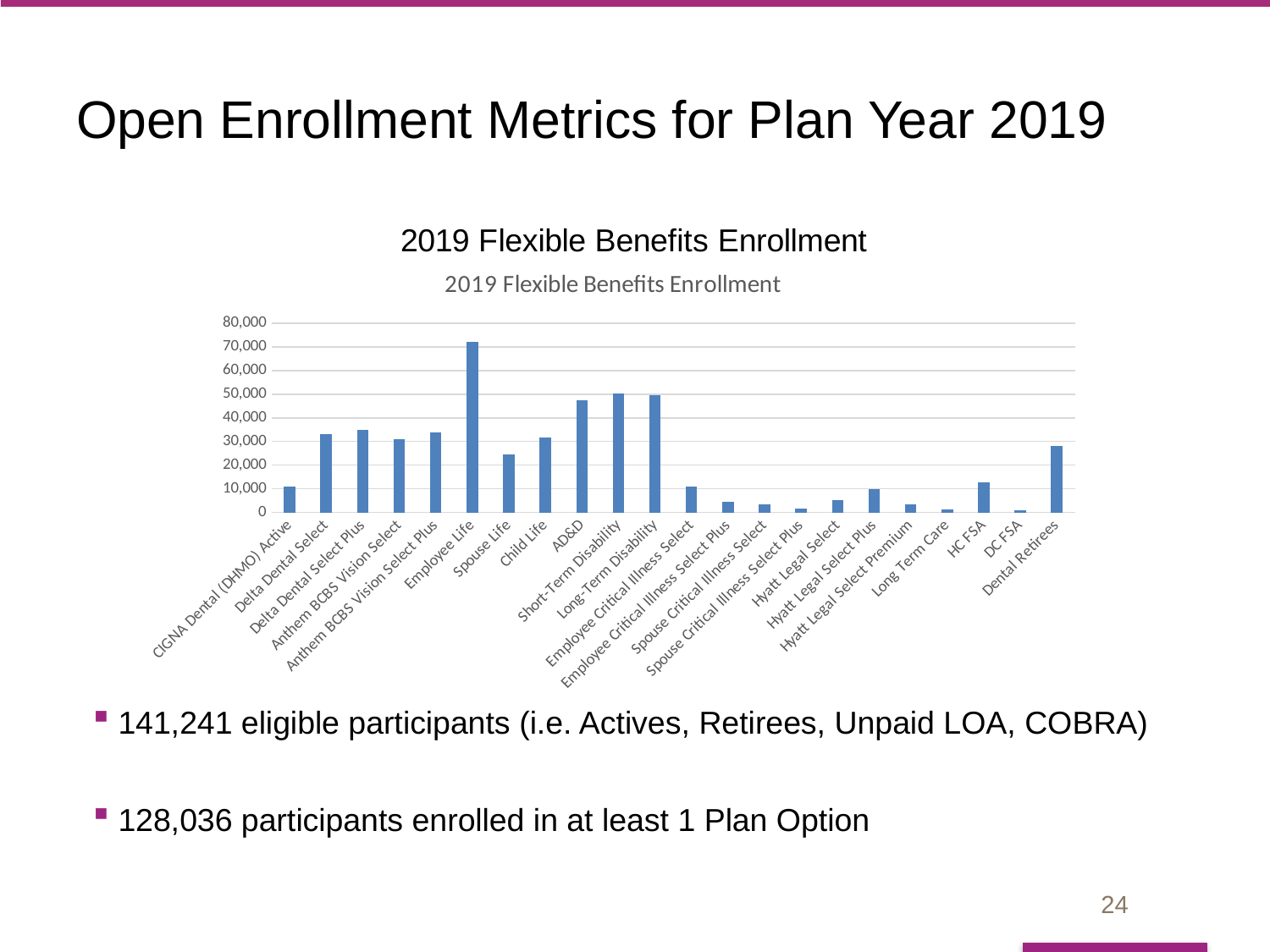
What is the title of the chart? 2019 Flexible Benefits Enrollment Which is larger, the value for Hyatt Legal Select or the value for Hyatt Legal Select Plus? Hyatt Legal Select Plus Which is larger, the value for Spouse Life or the value for Child Life? Child Life Which category has the highest enrollment in the chart? Employee Life How many categories are plotted on the x axis of the chart? 22 Is the value for Employee Life greater or less than 60,000? greater Is the value for AD&D greater or less than 40,000? greater Is the value for Delta Dental Select Plus greater or less than 30,000? greater Which is larger, the value for Employee Life or the value for Short-Term Disability? Employee Life What kind of chart is shown on the slide? Bar chart